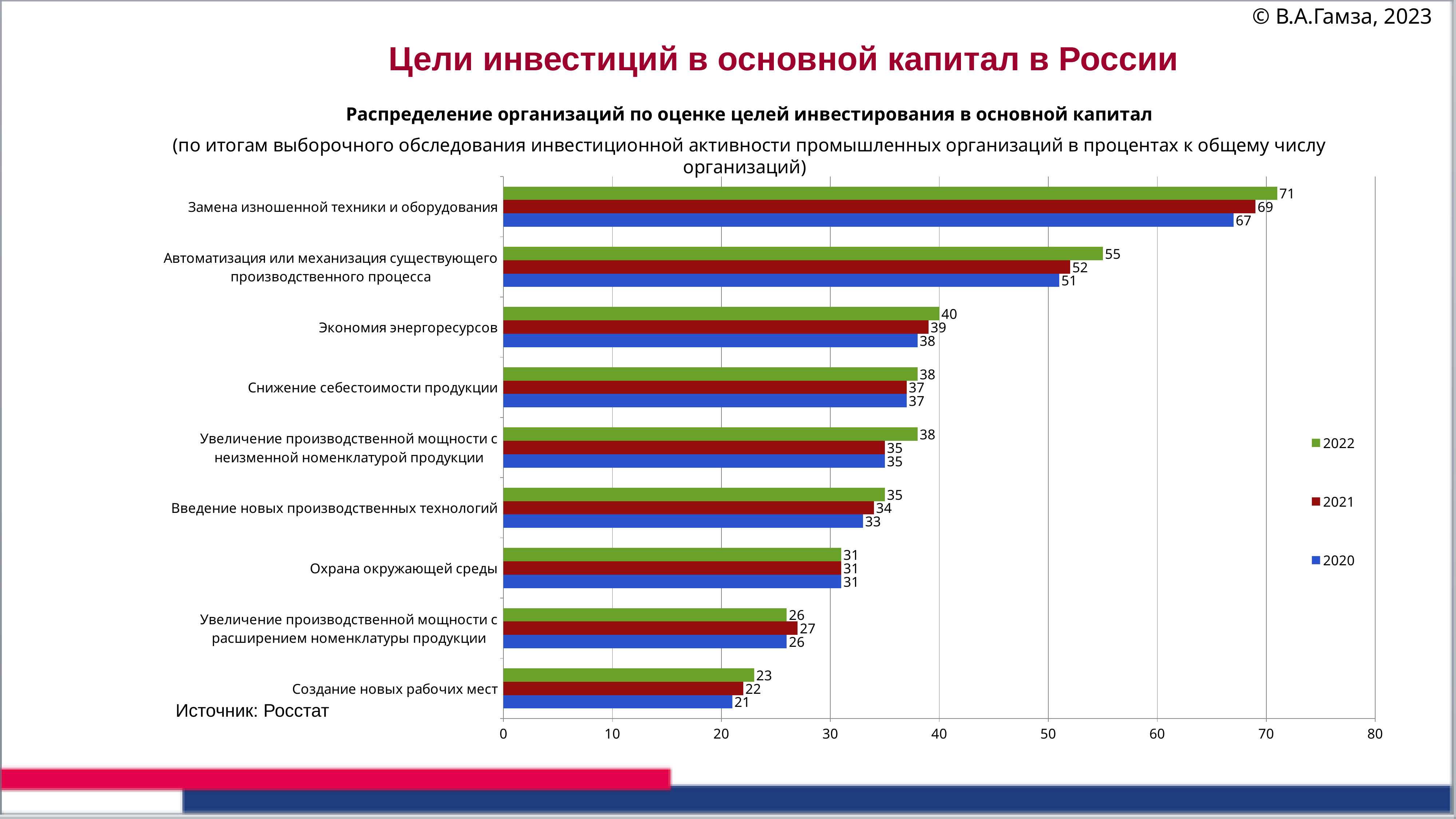
How many series does the legend list? 3 How many categories are shown on the chart? 9 Which colour represents the 2021 series in the legend? Dark red What is the 2021 value for «Экономия энергоресурсов»? 39 Which is larger: the 2022 value for «Экономия энергоресурсов» or the 2022 value for «Снижение себестоимости продукции»? Экономия энергоресурсов What is the difference between the 2022 and 2020 values for «Замена изношенной техники и оборудования»? 4 What kind of chart is shown on the slide? Bar chart Which category has the highest 2022 value? Замена изношенной техники и оборудования What is the 2022 value for «Замена изношенной техники и оборудования»? 71 Which category has the lowest 2020 value? Создание новых рабочих мест What is the 2021 value for «Увеличение производственной мощности с расширением номенклатуры продукции»? 27 What is the 2020 value for «Автоматизация или механизация существующего производственного процесса»? 51